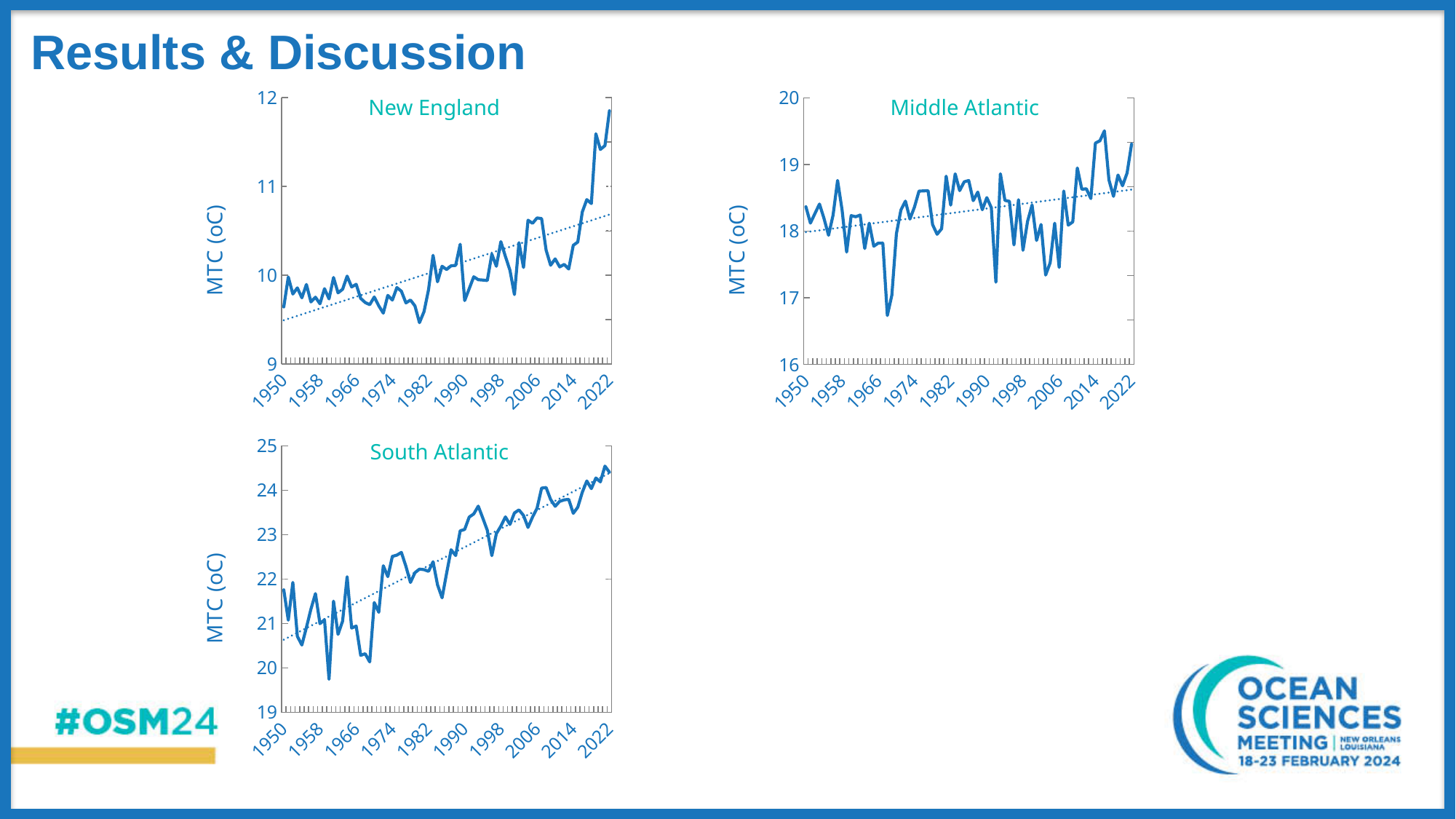
What kind of chart is the New England chart? line chart In the New England chart, is the MTC value around 1982 greater or less than 10? less In the South Atlantic chart, is the MTC value at 2022 greater or less than 24? greater How many charts are shown on the slide? 3 In the South Atlantic chart, do the MTC values generally rise or fall from 1950 to 2022? rise In the New England chart, do the MTC values generally rise or fall from 1950 to 2022? rise In the South Atlantic chart, is the lowest MTC value (around 1962) greater or less than 20? less What is the y-axis label on the South Atlantic chart? MTC (oC) In the Middle Atlantic chart, do the MTC values generally rise or fall over the period shown? rise